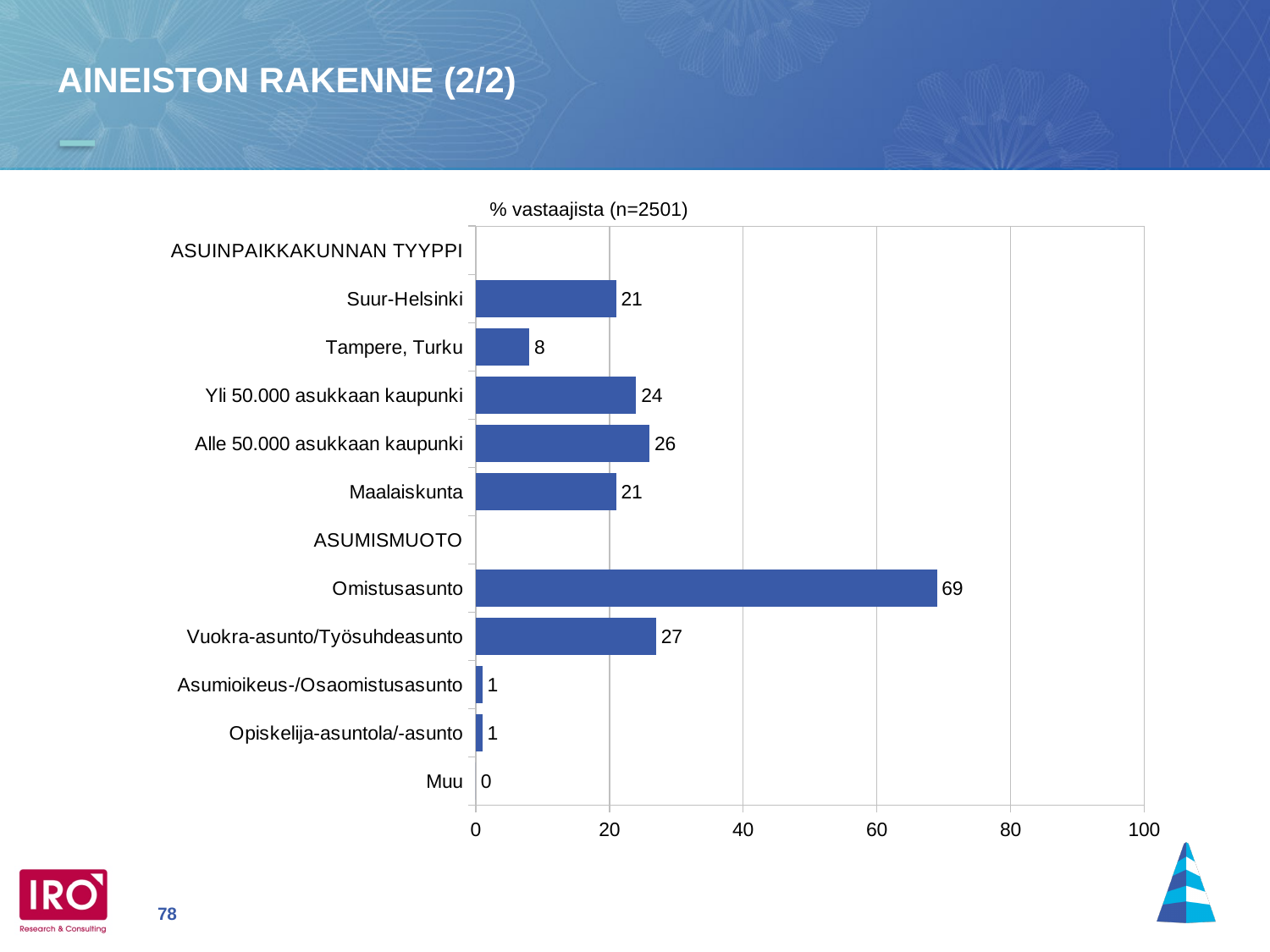
What is the value for Vuokra-asunto/Työsuhdeasunto? 27 What is the difference between the values for Alle 50.000 asukkaan kaupunki and Maalaiskunta? 5 What is the value for Alle 50.000 asukkaan kaupunki? 26 Which category has the highest value? Omistusasunto Which is larger, the value for Yli 50.000 asukkaan kaupunki or the value for Suur-Helsinki? Yli 50.000 asukkaan kaupunki Is the value for Omistusasunto greater or less than 60? greater What is the difference between the values for Omistusasunto and Vuokra-asunto/Työsuhdeasunto? 42 What kind of chart is shown on the slide? bar chart What is the title of the chart? % vastaajista (n=2501) Which category has the lowest value? Muu What is the value for Omistusasunto? 69 What is the value for Tampere, Turku? 8